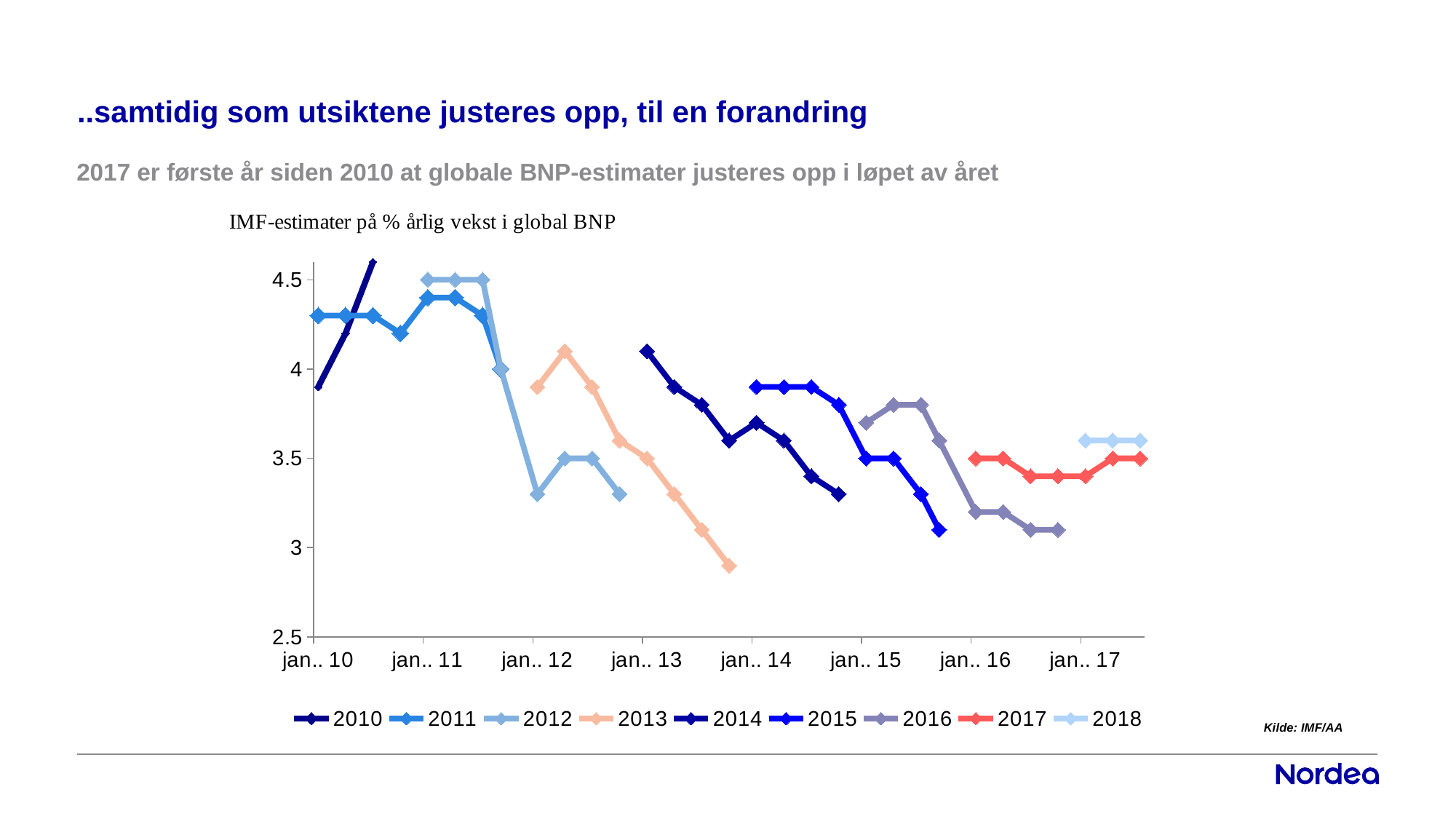
Is the last point of the 2010 series greater or less than 4.5? greater Which series ends at a lower value, 2013 or 2016? 2013 Is the last point of the 2013 series greater or less than 3? less Is the first point of the 2014 series greater or less than 4? greater Which series is drawn in red? 2017 How many labelled tick marks are on the x axis? 8 What is the title printed above the chart? IMF-estimater på % årlig vekst i global BNP How many series does the legend list? 9 What kind of chart is shown on the slide? line chart Do the values of the 2014 series rise or fall along the x axis? fall Which is higher, the first point of the 2014 series or the first point of the 2015 series? 2014